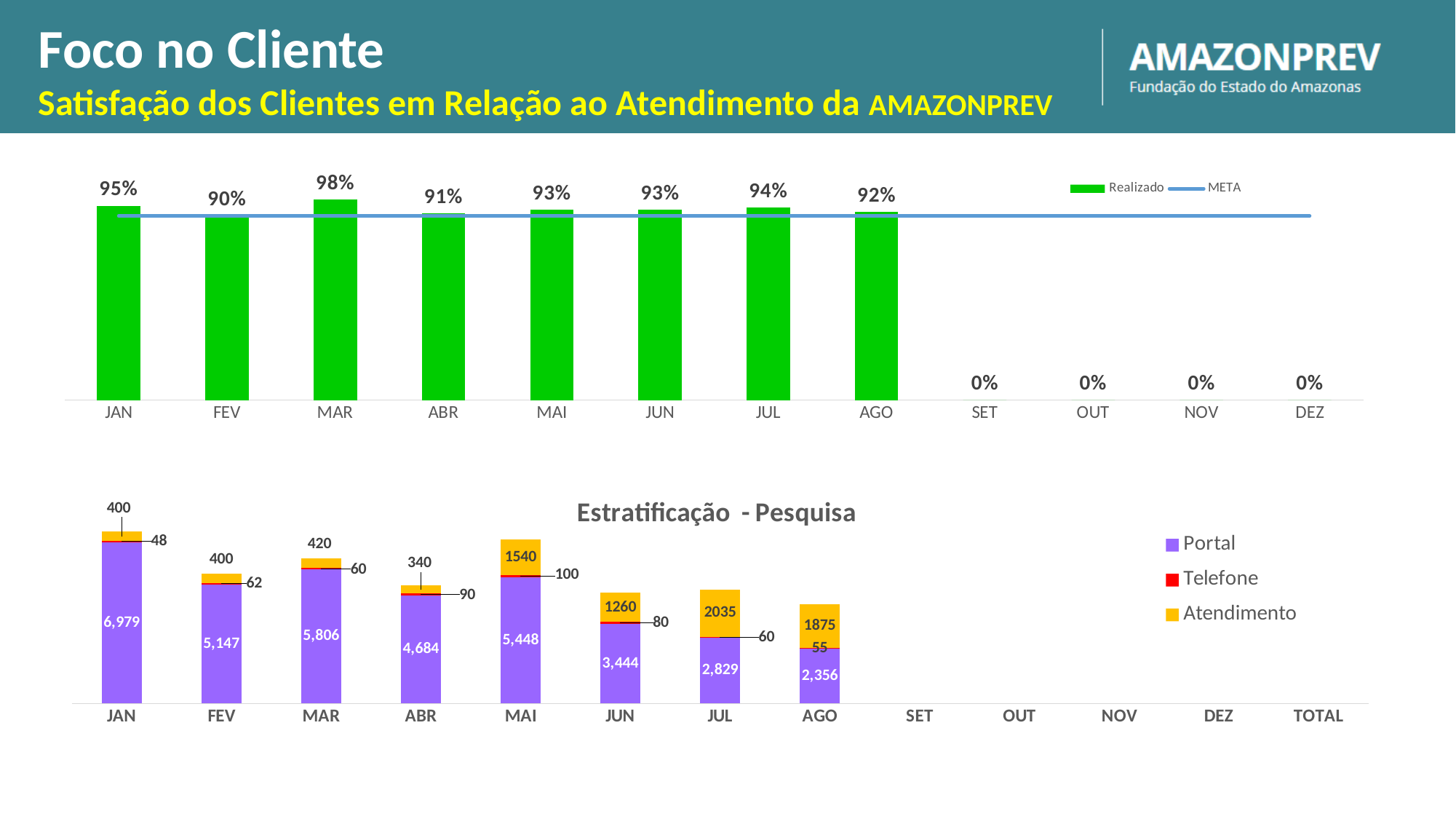
In the bottom chart (Estratificação - Pesquisa), what is the Atendimento value for JUL? 2035 In the bottom chart (Estratificação - Pesquisa), what is the total of the stacked bar for JAN? 7,427 In the bottom chart (Estratificação - Pesquisa), what is the Portal value for JAN? 6,979 In the top chart, what is the difference between the Realizado values for MAR and FEV? 8 percentage points In the top chart, how many series does the legend list? 2 In the bottom chart (Estratificação - Pesquisa), which is larger, the Telefone value for MAI or for JAN? MAI In the top chart, what is the Realizado value for MAR? 98% What kind of chart is the top chart? Bar chart with a line In the bottom chart (Estratificação - Pesquisa), how many series does the legend list? 3 In the top chart, among the months JAN to AGO, which has the lowest Realizado value? FEV In the bottom chart (Estratificação - Pesquisa), which month has the highest Atendimento value? JUL In the top chart, which month has the highest Realizado value? MAR